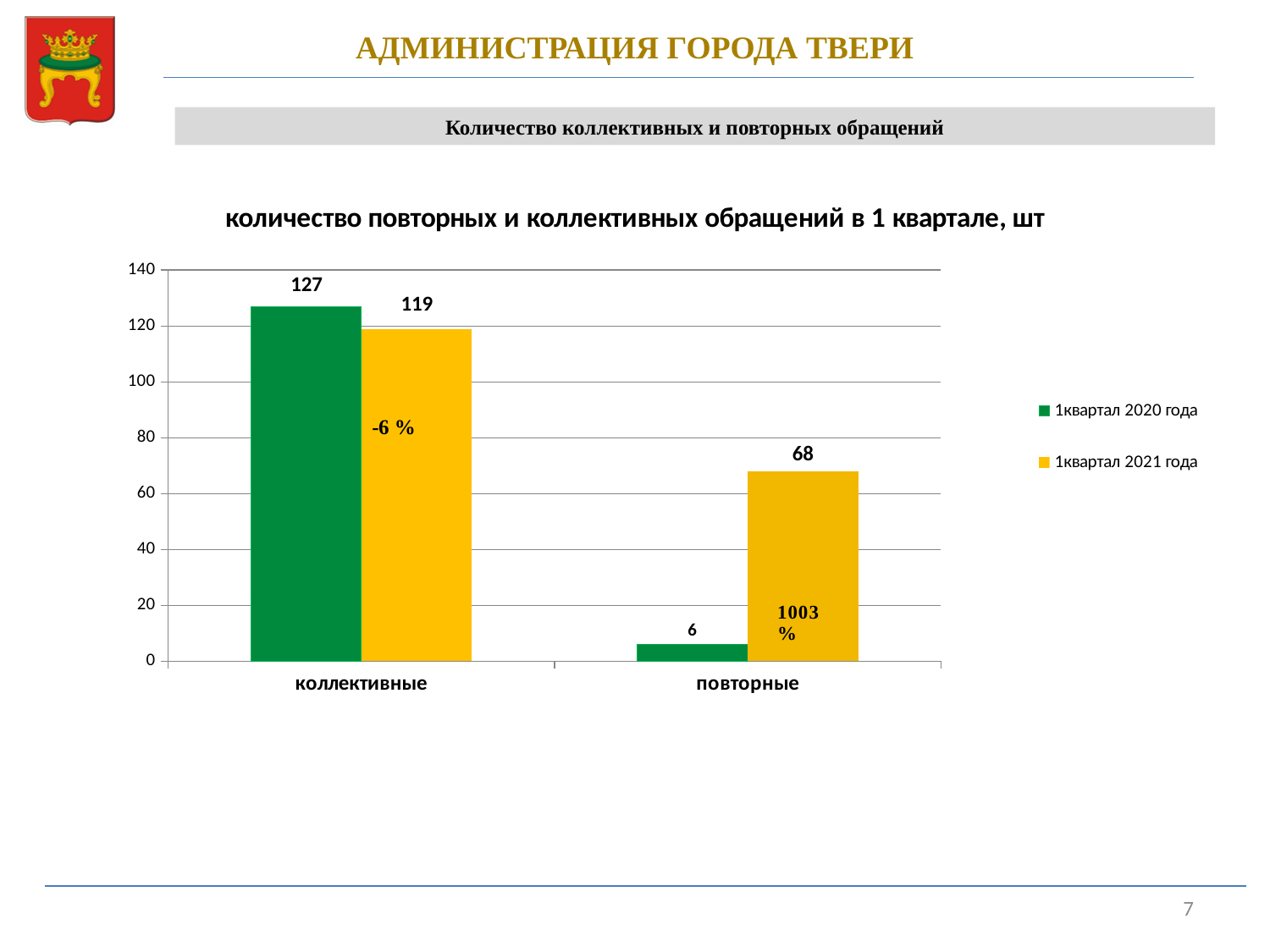
What is the value for коллективные in 1квартал 2021 года? 119 Which category has the lowest value in 1квартал 2020 года? повторные What is the value for повторные in 1квартал 2021 года? 68 What is the value for коллективные in 1квартал 2020 года? 127 Which category has the highest value in 1квартал 2021 года? коллективные What is the difference between the 1квартал 2021 года and 1квартал 2020 года values for повторные? 62 How many series does the legend list? 2 What is the value for повторные in 1квартал 2020 года? 6 What is the difference between the 1квартал 2020 года and 1квартал 2021 года values for коллективные? 8 How many categories are shown on the x axis? 2 Which is larger for повторные: the 1квартал 2020 года value or the 1квартал 2021 года value? 1квартал 2021 года What kind of chart is shown on the slide? bar chart